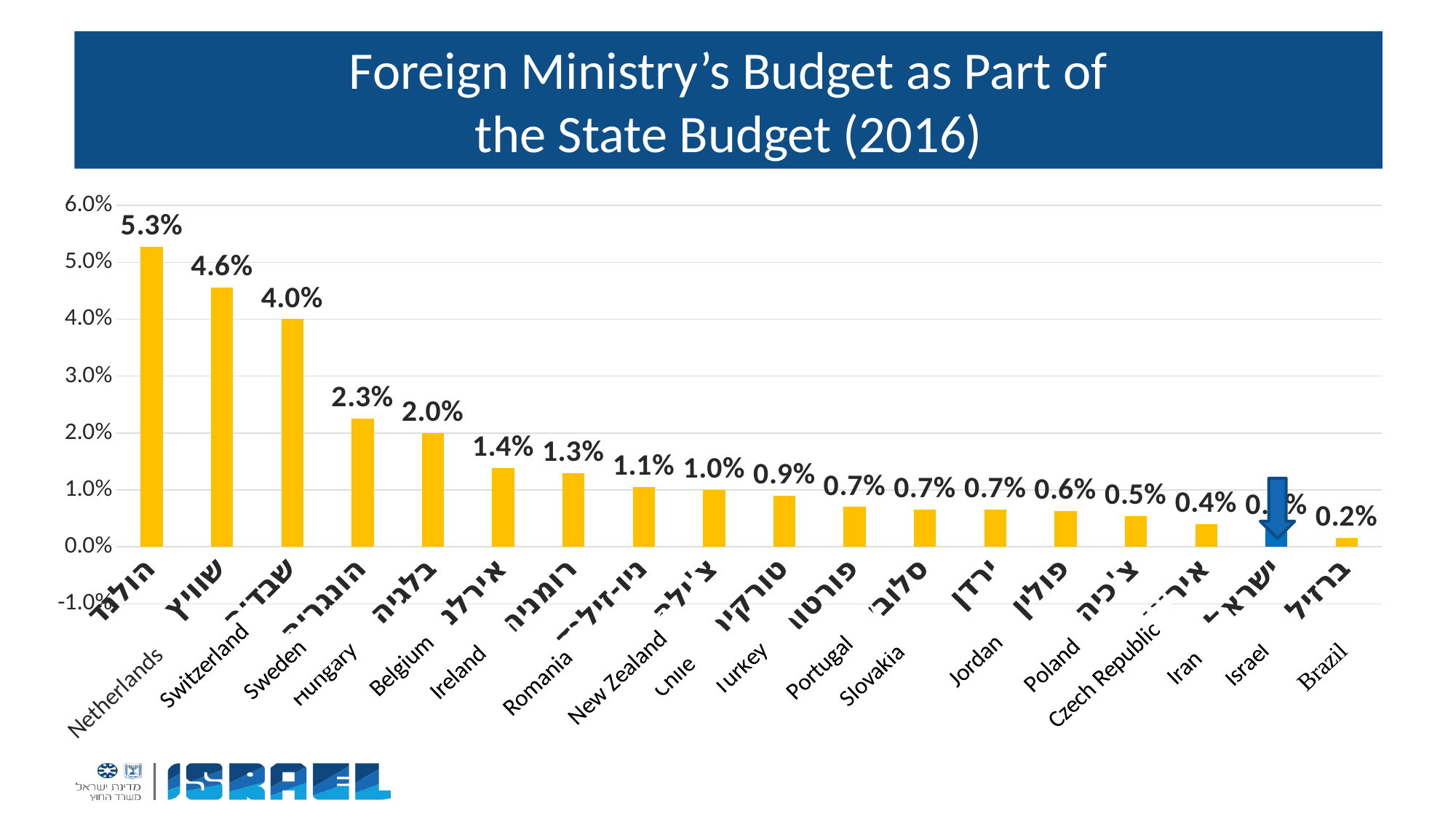
What is the value for Czech Republic? 0.5% Which country has the lowest value? Brazil What is the value for Netherlands? 5.3% What is the value for Brazil? 0.2% How many countries are shown in the chart? 18 Do the values rise or fall from left to right along the x axis? fall What kind of chart is this? bar chart What is the difference between the values for Switzerland and Sweden? 0.6% Which country has the highest value? Netherlands Which is larger, the value for Ireland or the value for Turkey? Ireland What is the value for Hungary? 2.3% Is the value for Israel greater or less than 1.0%? less